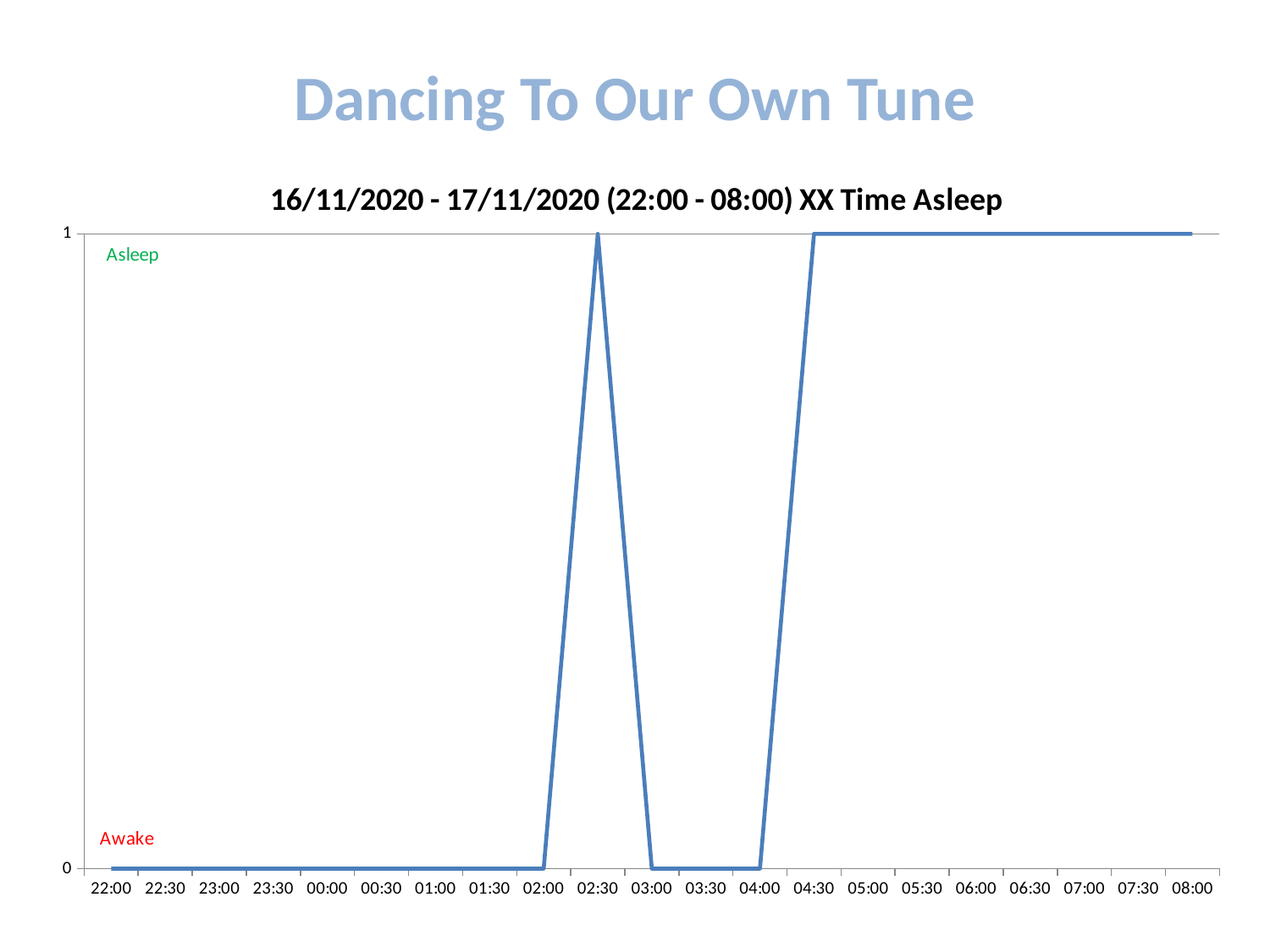
What is the value at 23:00? 0 Does the value rise or fall between 04:00 and 04:30? Rise What is the value at 02:30? 1 What is the difference between the value at 04:30 and the value at 04:00? 1 What is the value at 06:00? 1 What label is shown in green near the top of the chart? Asleep How many time points are shown on the x axis? 21 What kind of chart is shown on the slide? Line chart What is the title of the chart? 16/11/2020 - 17/11/2020 (22:00 - 08:00) XX Time Asleep What is the value at 08:00? 1 Which is larger, the value at 02:30 or the value at 03:00? 02:30 What is the value at 03:30? 0